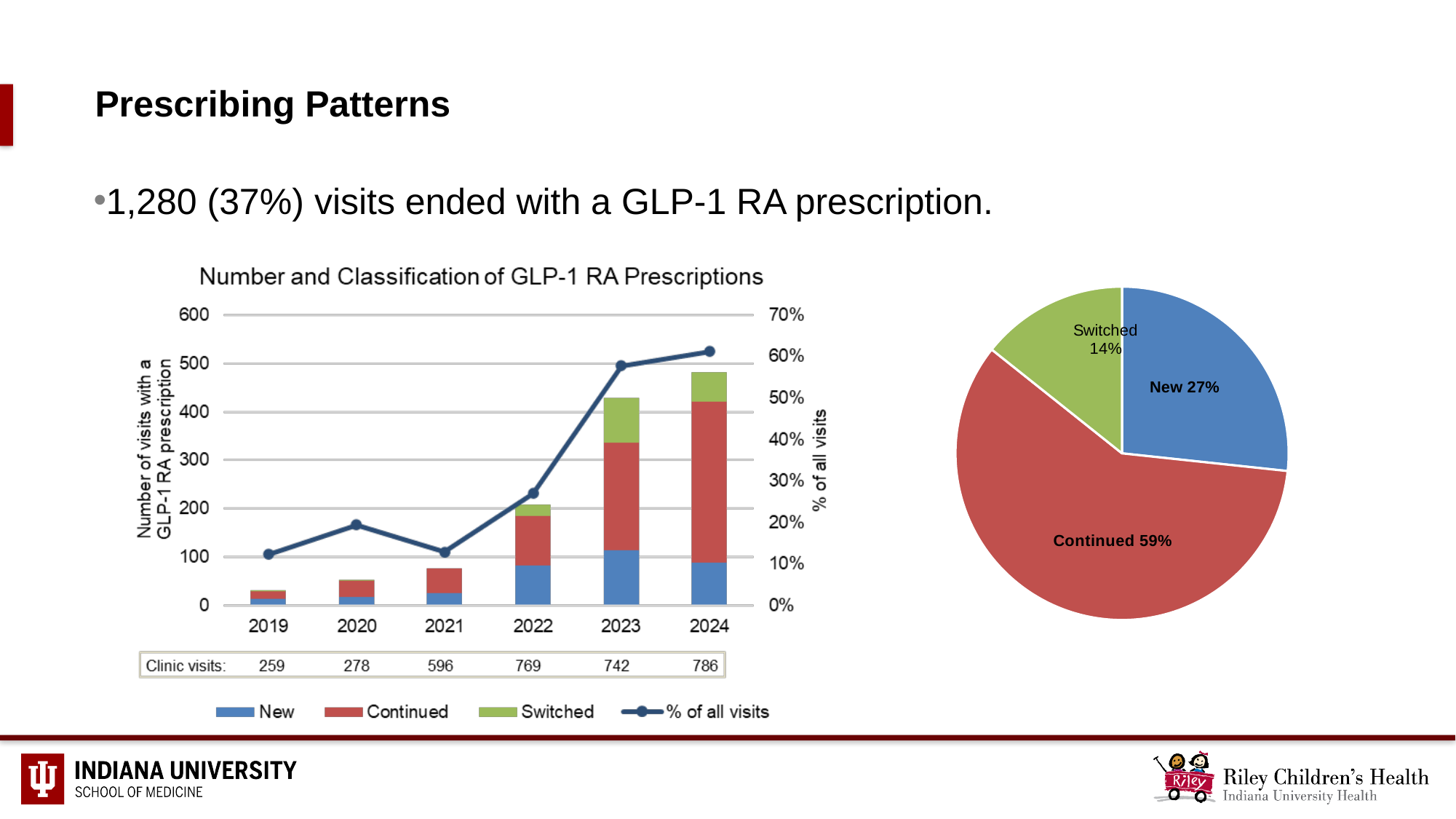
On the pie chart, what share of prescriptions is labelled New? 27% On the pie chart, what share of prescriptions is labelled Switched? 14% In the chart titled 'Number and Classification of GLP-1 RA Prescriptions', is the '% of all visits' value for 2023 greater or less than 50%? greater In the chart titled 'Number and Classification of GLP-1 RA Prescriptions', is the total number of visits with a GLP-1 RA prescription in 2024 greater or less than 400? greater On the pie chart, which slice is the smallest? Switched In the chart titled 'Number and Classification of GLP-1 RA Prescriptions', how many clinic visits are listed for 2022? 769 On the pie chart, which slice is the largest? Continued On the pie chart, what share of prescriptions is labelled Continued? 59% In the chart titled 'Number and Classification of GLP-1 RA Prescriptions', how many entries does the legend list? 4 On the pie chart, what is the difference between the Continued share and the New share? 32% In the chart titled 'Number and Classification of GLP-1 RA Prescriptions', which year has the tallest stacked bar? 2024 In the chart titled 'Number and Classification of GLP-1 RA Prescriptions', how many years are shown on the x axis? 6